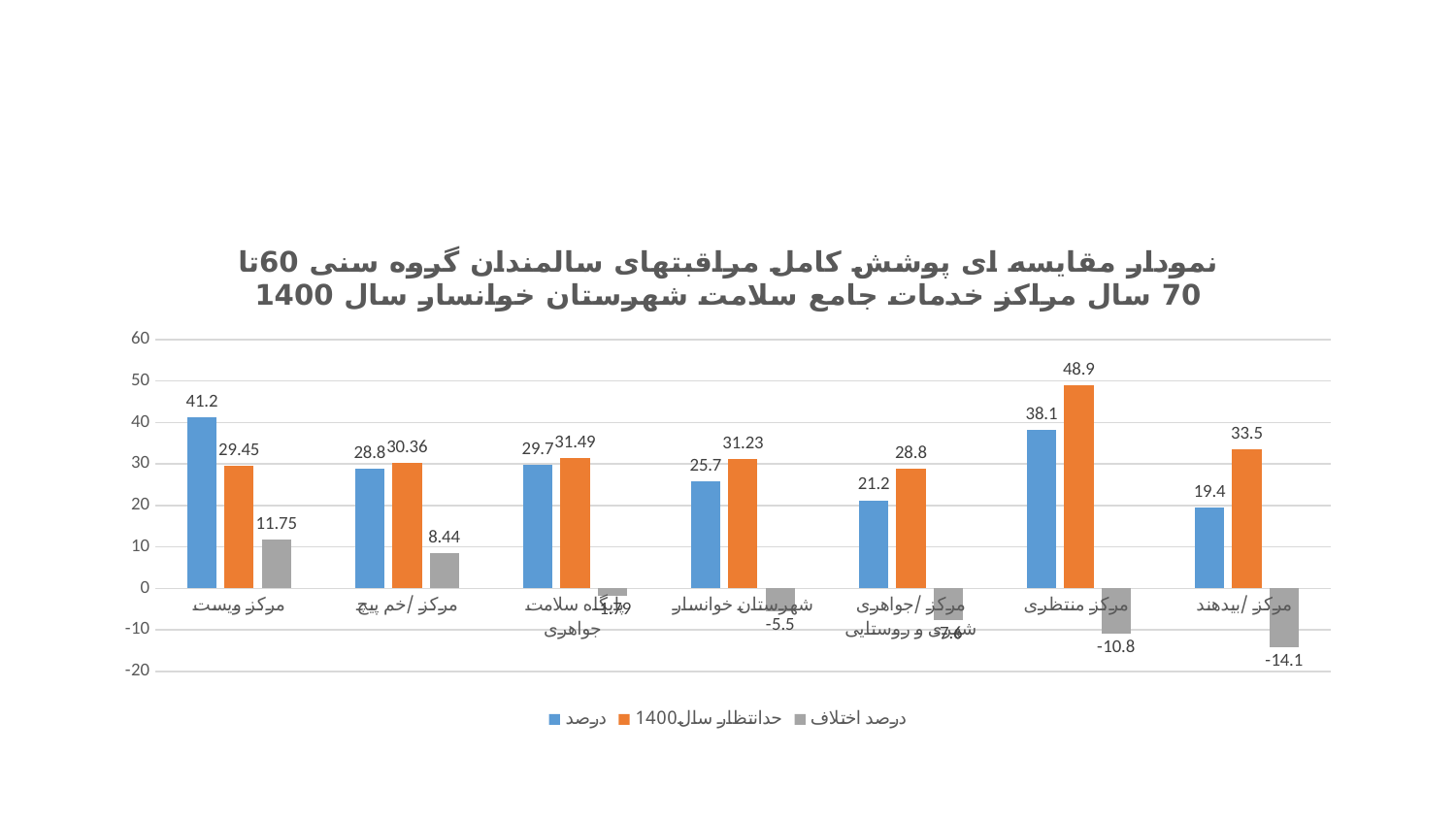
Is the value of درصد for مرکز ویست greater or less than 40? greater Which category has the highest value for حدانتظار سال1400? مرکز منتظری What is the value of حدانتظار سال1400 for مرکز منتظری? 48.9 What type of chart is shown on the slide? bar chart How many categories are shown on the x axis? 7 What is the value of درصد for مرکز ویست? 41.2 How many series does the legend list? 3 What colour are the bars for the series درصد اختلاف? gray Which category has the lowest value for درصد? مرکز/بیدهند What is the difference between حدانتظار سال1400 and درصد for مرکز منتظری? 10.8 Which is larger for مرکز ویست: درصد or حدانتظار سال1400? درصد What is the value of درصد اختلاف for مرکز/بیدهند? -14.1